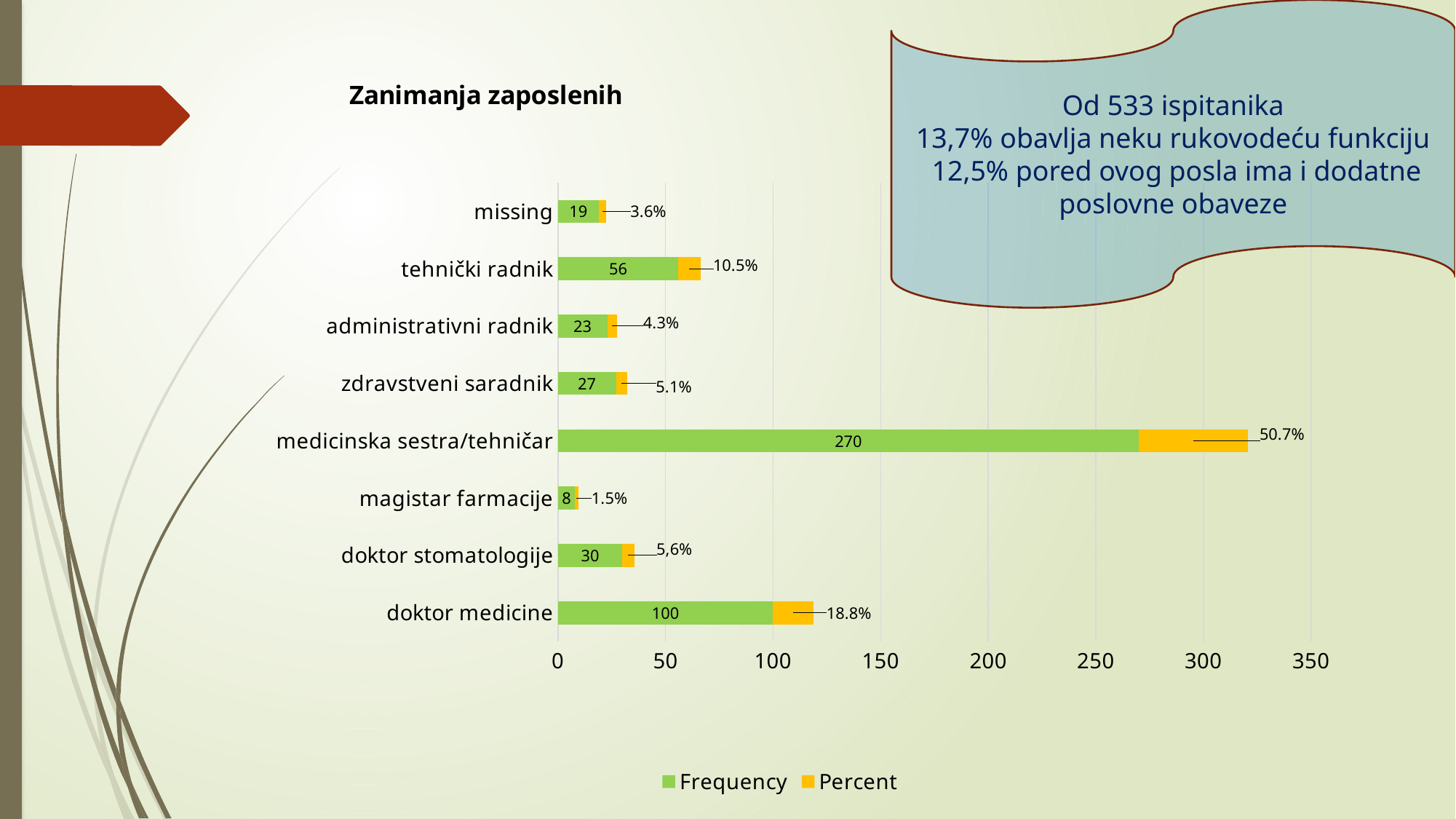
Which category has the highest Frequency? medicinska sestra/tehničar Which has a higher Frequency, zdravstveni saradnik or administrativni radnik? zdravstveni saradnik How many categories are shown on the chart? 8 What is the Frequency value for tehnički radnik? 56 What is the Frequency value for medicinska sestra/tehničar? 270 What kind of chart is shown on the slide? bar chart What is the Percent value for magistar farmacije? 1.5% What is the difference in Frequency between doktor medicine and doktor stomatologije? 70 Which category has the lowest Frequency? magistar farmacije How many series does the legend list? 2 What is the Percent value for doktor medicine? 18.8% What is the title of the chart? Zanimanja zaposlenih